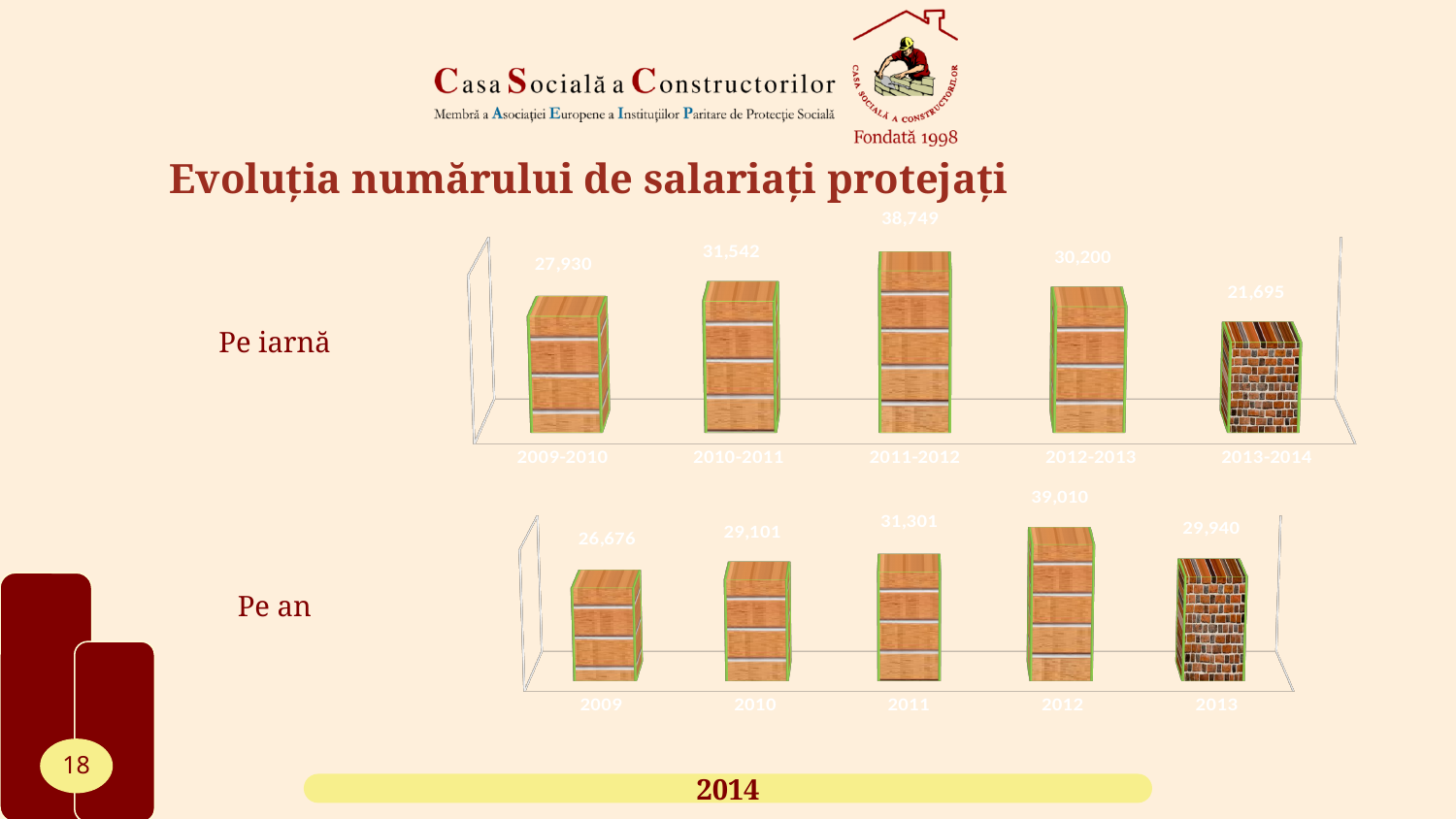
In the 'Pe an' chart, what is the difference between the values for 2012 and 2013? 9,070 In the 'Pe an' chart, what is the value for 2009? 26,676 In the 'Pe iarnă' chart, which period has the highest value? 2011-2012 In the 'Pe iarnă' chart, what is the difference between the values for 2010-2011 and 2009-2010? 3,612 In the 'Pe iarnă' chart, which period has the lowest value? 2013-2014 In the 'Pe an' chart, which is larger, the value for 2011 or the value for 2013? 2011 In the 'Pe an' chart, what is the value for 2012? 39,010 In the 'Pe an' chart, which year has the highest value? 2012 In the 'Pe iarnă' chart, what is the value for 2011-2012? 38,749 What kind of chart is the 'Pe an' chart? Bar chart In the 'Pe iarnă' chart, what is the value for 2013-2014? 21,695 In the 'Pe iarnă' chart, how many periods are shown? 5